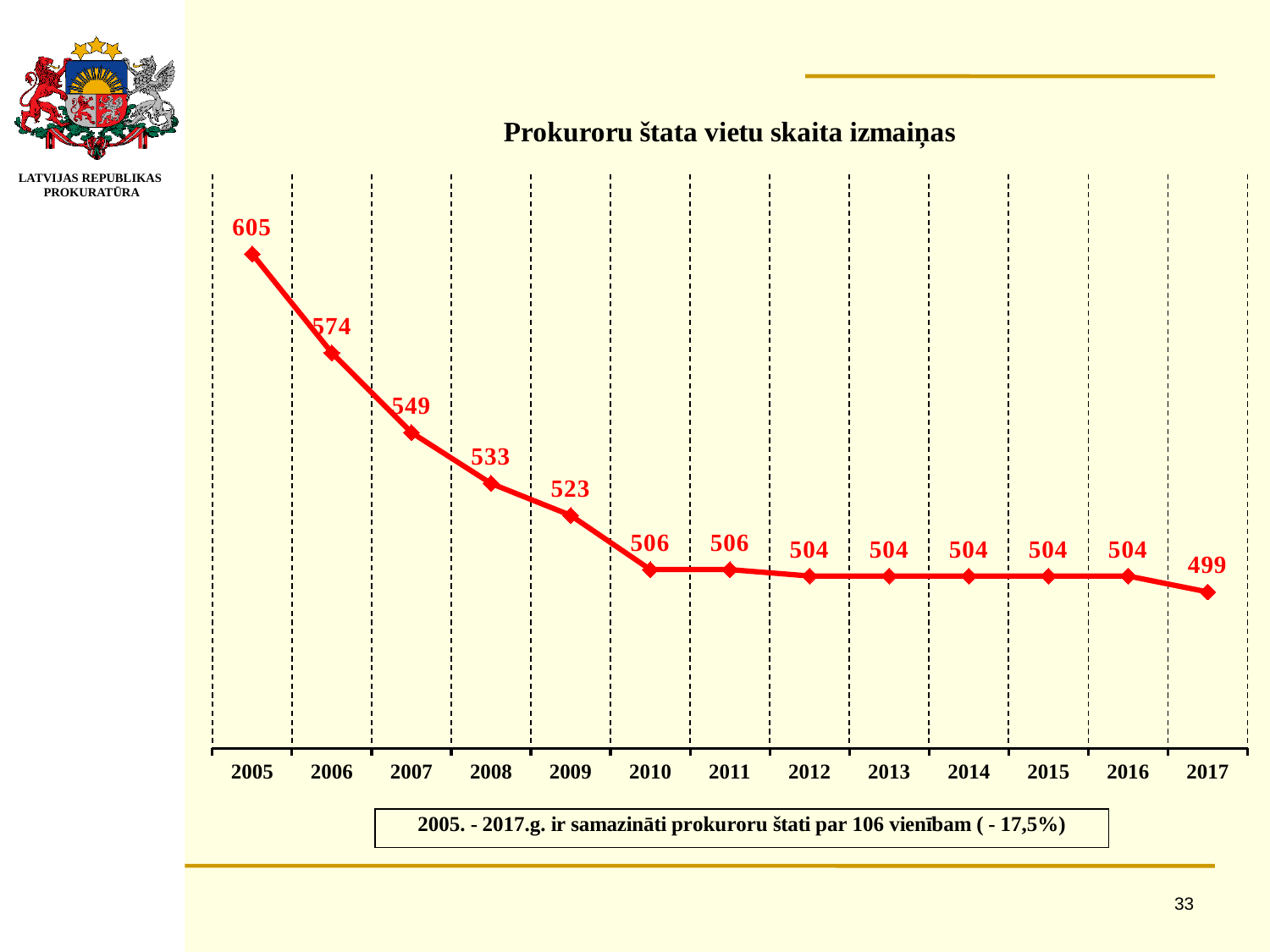
Which year has the lowest value? 2017 What is the value for 2009? 523 What is the value for 2005? 605 Which year has the highest value? 2005 What is the value for 2017? 499 What kind of chart is shown? line chart Do the values rise or fall from 2005 to 2017? fall What is the difference between the values for 2006 and 2007? 25 What is the difference between the values for 2005 and 2017? 106 What is the title of the chart? Prokuroru štata vietu skaita izmaiņas How many years are plotted on the chart? 13 Which is larger, the value for 2008 or the value for 2010? 2008